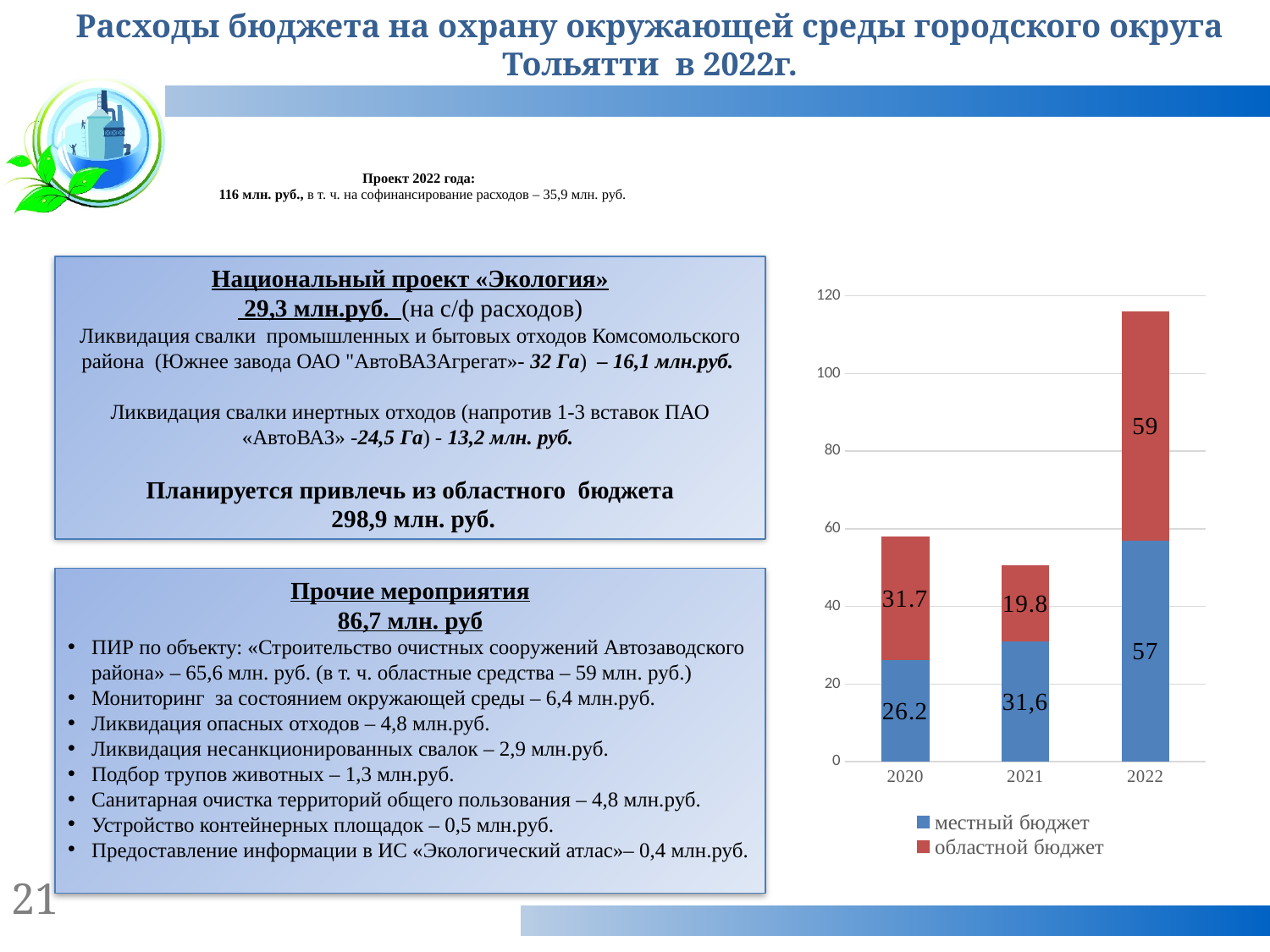
Which year has the lowest value for местный бюджет? 2020 What is the total of the stacked bar for 2022? 116 What is the difference between областной бюджет in 2022 and in 2021? 39.2 What type of chart is shown on the slide? stacked bar chart Which is larger in 2020: местный бюджет or областной бюджет? областной бюджет How many years are shown on the x axis? 3 What is the value of областной бюджет for 2022? 59 What is the value of областной бюджет for 2021? 19.8 Which year has the highest value for областной бюджет? 2022 What is the value of местный бюджет for 2022? 57 What is the value of местный бюджет for 2020? 26.2 How many series does the legend list? 2